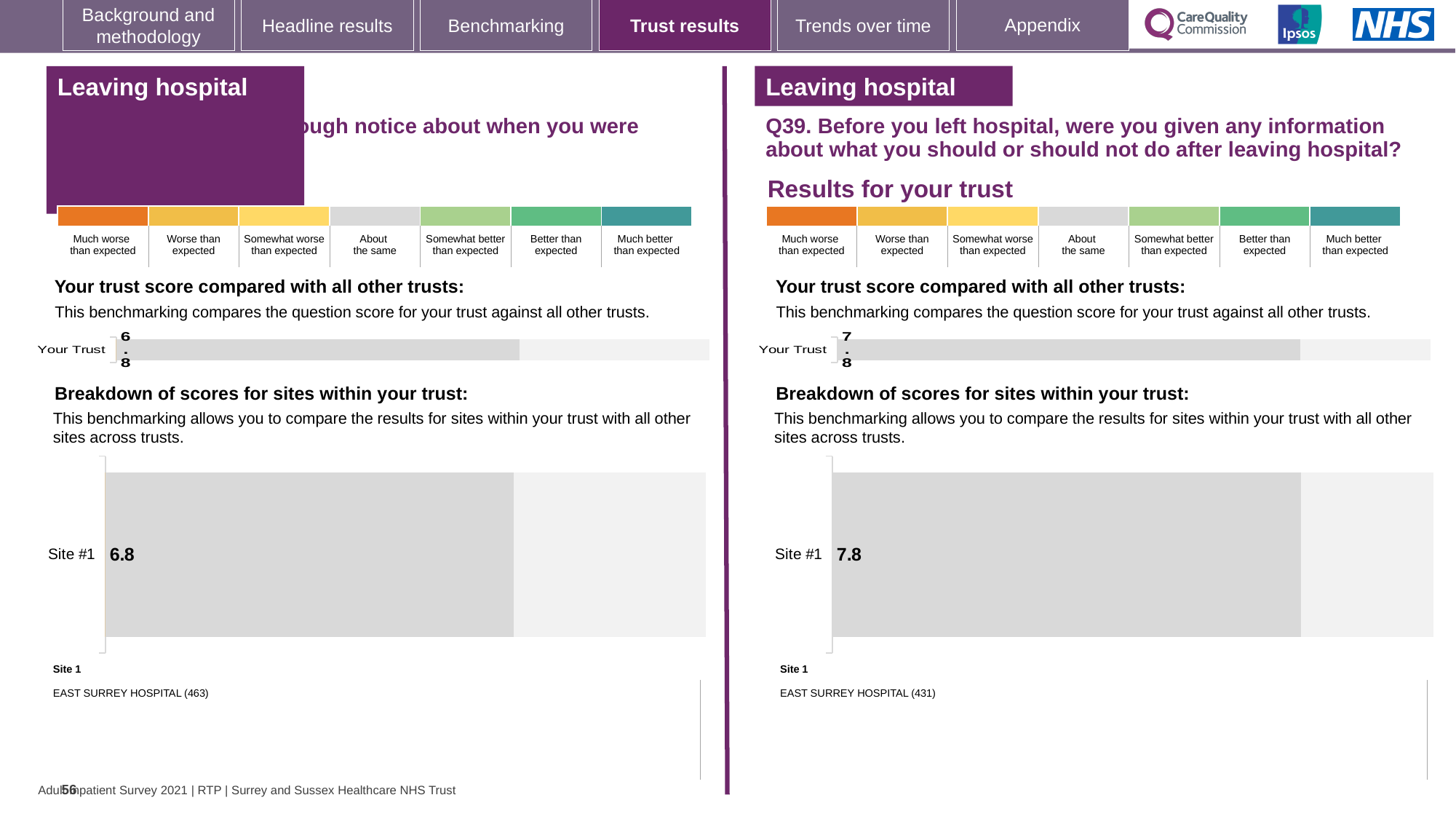
How many sites are shown in the breakdown of scores on the right panel (Q39)? 1 On the right panel's (Q39) breakdown of scores for sites, what is the score for Site #1? 7.8 What type of chart is used to show the Site #1 score on the right panel (Q39)? Bar chart What is the difference between the Your Trust score on the right panel (Q39) and the Your Trust score on the left panel? 1.0 On the left panel, what is the score shown for Your Trust? 6.8 On the right panel (Q39), what is the score shown for Your Trust? 7.8 How many sites are shown in the breakdown of scores on the left panel? 1 Which is larger: the Site #1 score on the left panel or the Site #1 score on the right panel (Q39)? Right panel (Q39) Which hospital is listed as Site 1 on the right panel (Q39)? EAST SURREY HOSPITAL (431) On the left panel's breakdown of scores for sites, what is the score for Site #1? 6.8 Which hospital is listed as Site 1 on the left panel? EAST SURREY HOSPITAL (463)